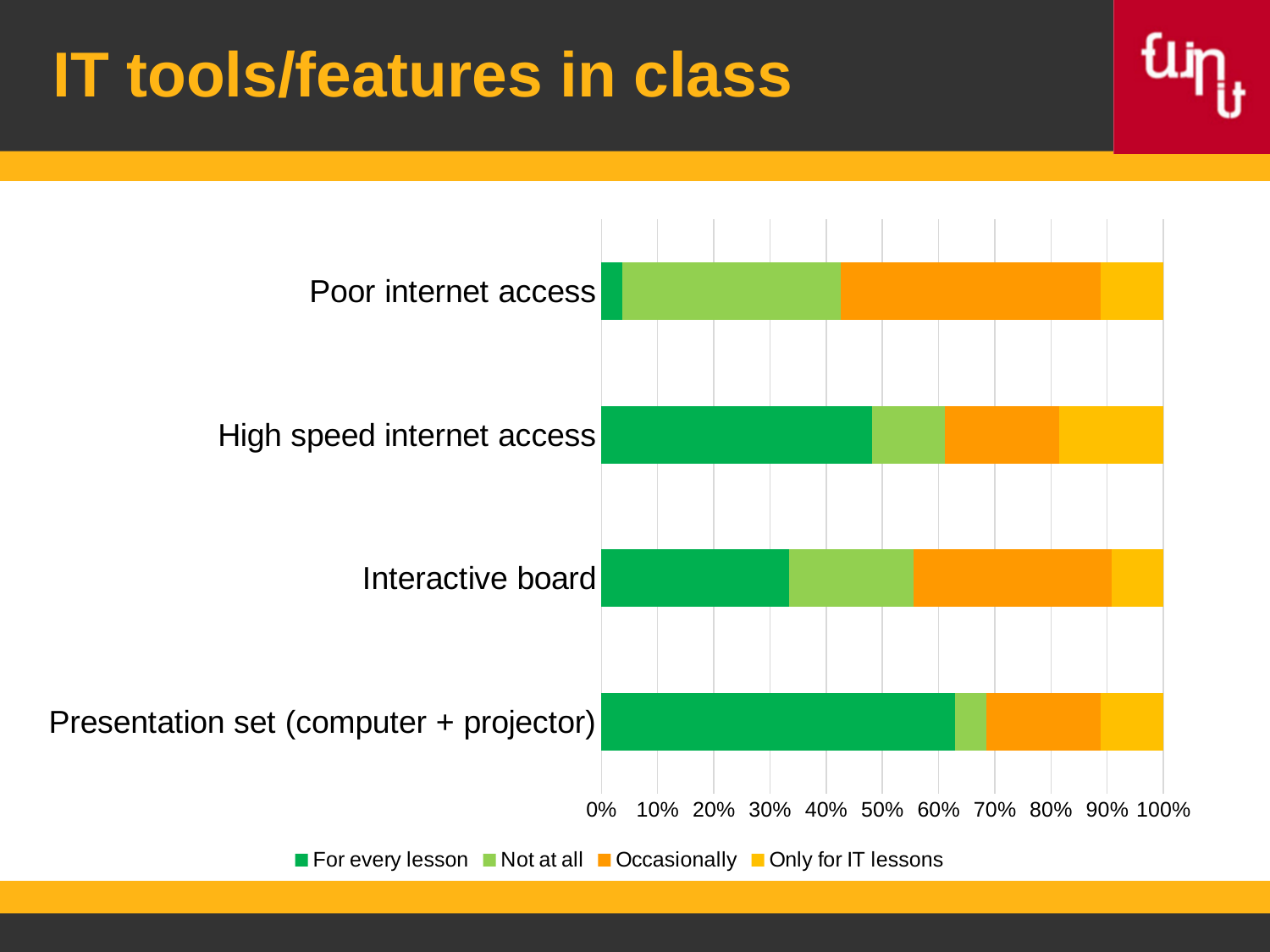
How many categories (IT tools/features) are plotted on the chart? 4 Is the 'For every lesson' share for Presentation set (computer + projector) greater or less than 60%? greater How many series does the legend list? 4 Is the 'For every lesson' share for Poor internet access greater or less than 10%? less What does each full stacked bar add up to on the x axis? 100% Which category has the largest 'For every lesson' share? Presentation set (computer + projector) Which is larger: the 'For every lesson' share for High speed internet access or for Interactive board? High speed internet access Which category has the smallest 'For every lesson' share? Poor internet access Is the 'For every lesson' share for Interactive board greater or less than 40%? less What kind of chart is shown on the slide? Stacked bar chart Which category has the largest 'Not at all' share? Poor internet access What is the title of the slide containing the chart? IT tools/features in class